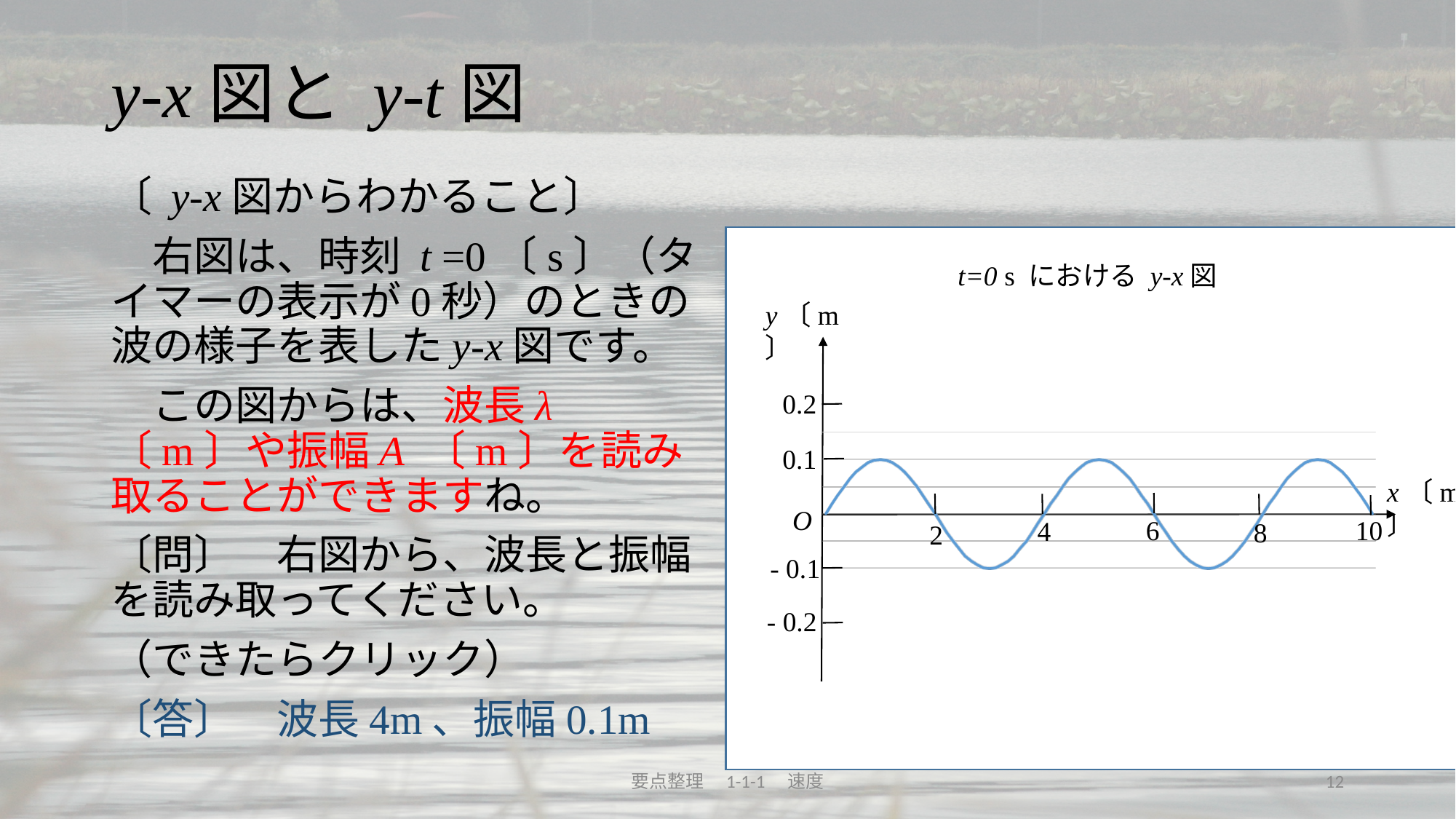
Is the value of y at x = 3 greater or less than 0? less What is the value of y at x = 4 in the chart? 0 Is the value of y at x = 1 greater or less than 0? greater What kind of chart is shown on the slide? line chart What is the highest value of y reached by the wave in the chart? 0.1 What is the label and unit of the vertical axis of the chart? y 〔m〕 What is the lowest value of y reached by the wave in the chart? - 0.1 Is the peak value of the wave greater or less than 0.2? less What is the title of the chart? t=0 s における y-x 図 How many peaks (crests) does the wave show in the chart? 3 What is the largest value labelled on the x axis of the chart? 10 What is the value of y at x = 2 in the chart? 0